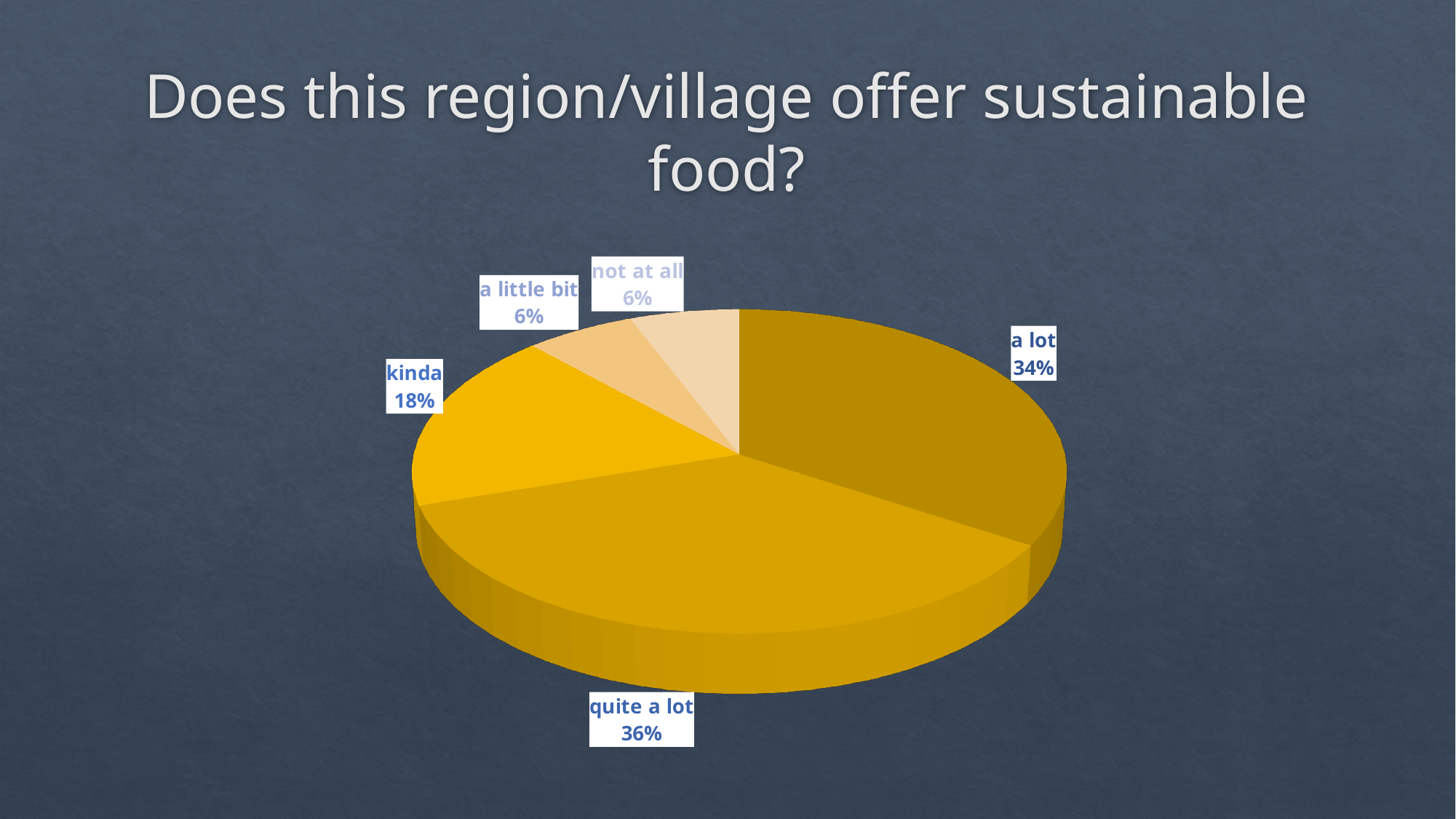
What percentage of respondents answered "quite a lot"? 36% Which response has the largest share of the pie? quite a lot Which is larger, the share for "kinda" or the share for "a little bit"? kinda What percentage of respondents answered "a lot"? 34% What is the combined share of "a lot" and "quite a lot"? 70% What kind of chart is shown on the slide? pie chart What is the difference in percentage points between "kinda" and "a little bit"? 12 What is the title of the slide containing the pie chart? Does this region/village offer sustainable food? What percentage of respondents answered "kinda"? 18% How many response categories are shown in the pie chart? 5 What is the difference in percentage points between "quite a lot" and "a lot"? 2 What percentage of respondents answered "not at all"? 6%